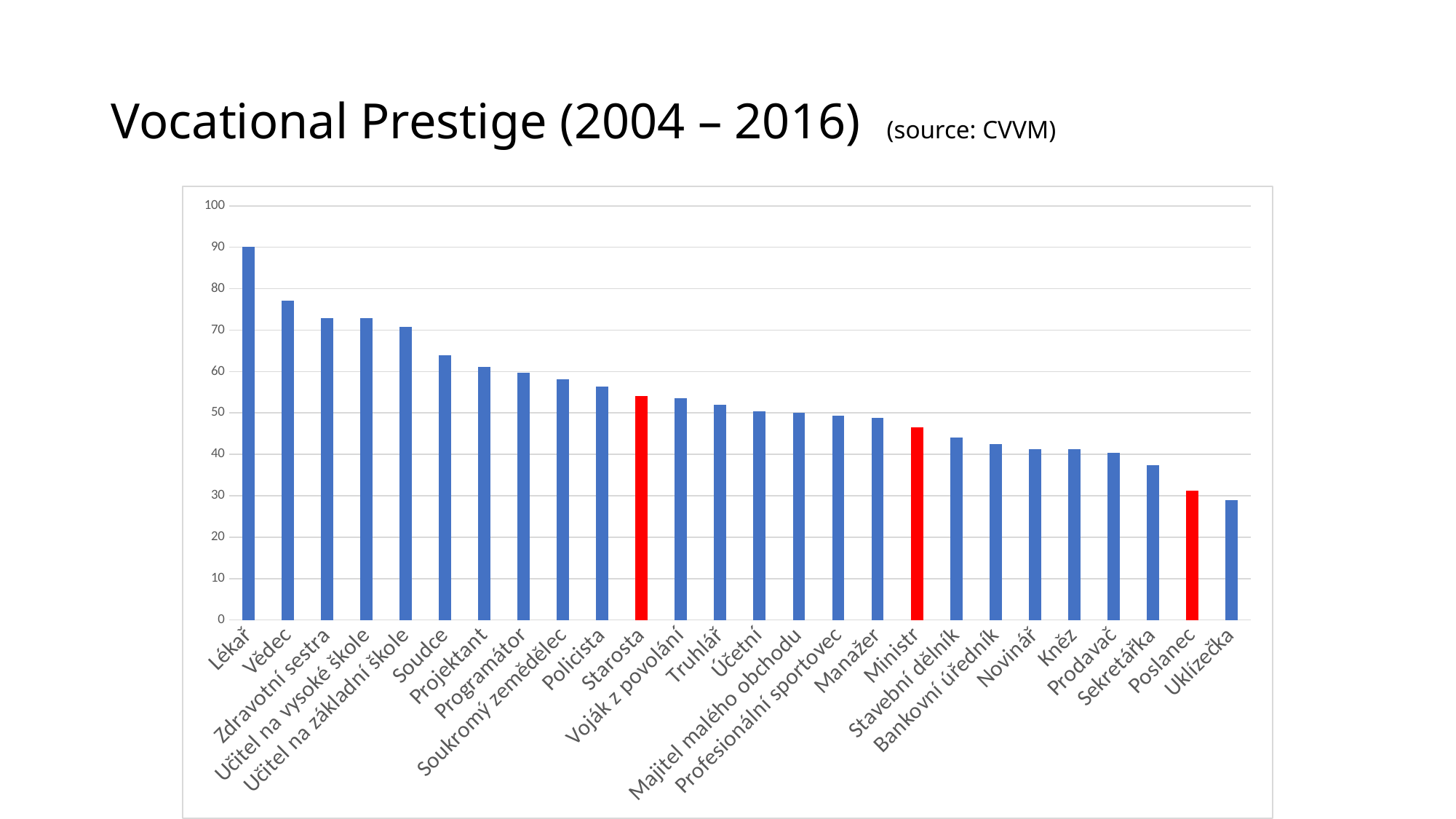
Which is larger, the value for Starosta or the value for Ministr? Starosta Is the value for Vědec greater or less than 70? greater How many bars are coloured red? 3 Which category has the highest value? Lékař Do the values rise or fall from left to right along the x axis? fall Which is larger, the value for Sekretářka or the value for Poslanec? Sekretářka What kind of chart is shown on the slide? bar chart How many categories are plotted on the x axis? 26 Is the value for Ministr greater or less than 50? less Which category has the lowest value? Uklízečka Is the value for Soudce greater or less than 60? greater